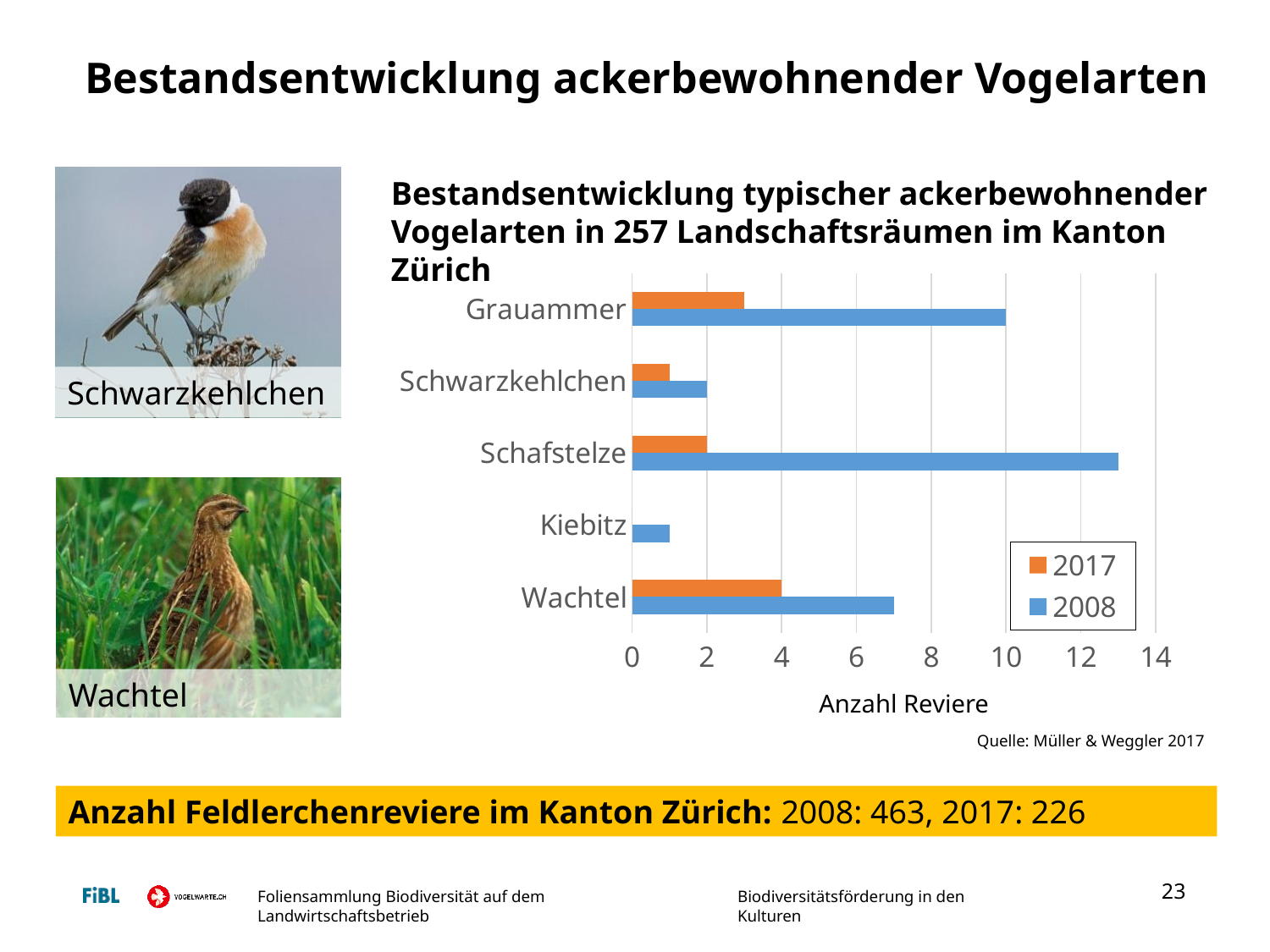
How many series does the chart legend list? 2 Which species has the highest value for 2017? Wachtel What is the value for Schafstelze in 2017? 2 Is the value for Schafstelze in 2008 greater or less than 12? greater For Grauammer, which is larger: the 2008 value or the 2017 value? 2008 What is the value for Wachtel in 2017? 4 What kind of chart is shown on the slide? bar chart What is the label of the horizontal axis? Anzahl Reviere How many bird species (categories) are shown on the chart? 5 Which species has the lowest value for 2008? Kiebitz Which species has the highest value for 2008? Schafstelze What is the value for Grauammer in 2008? 10